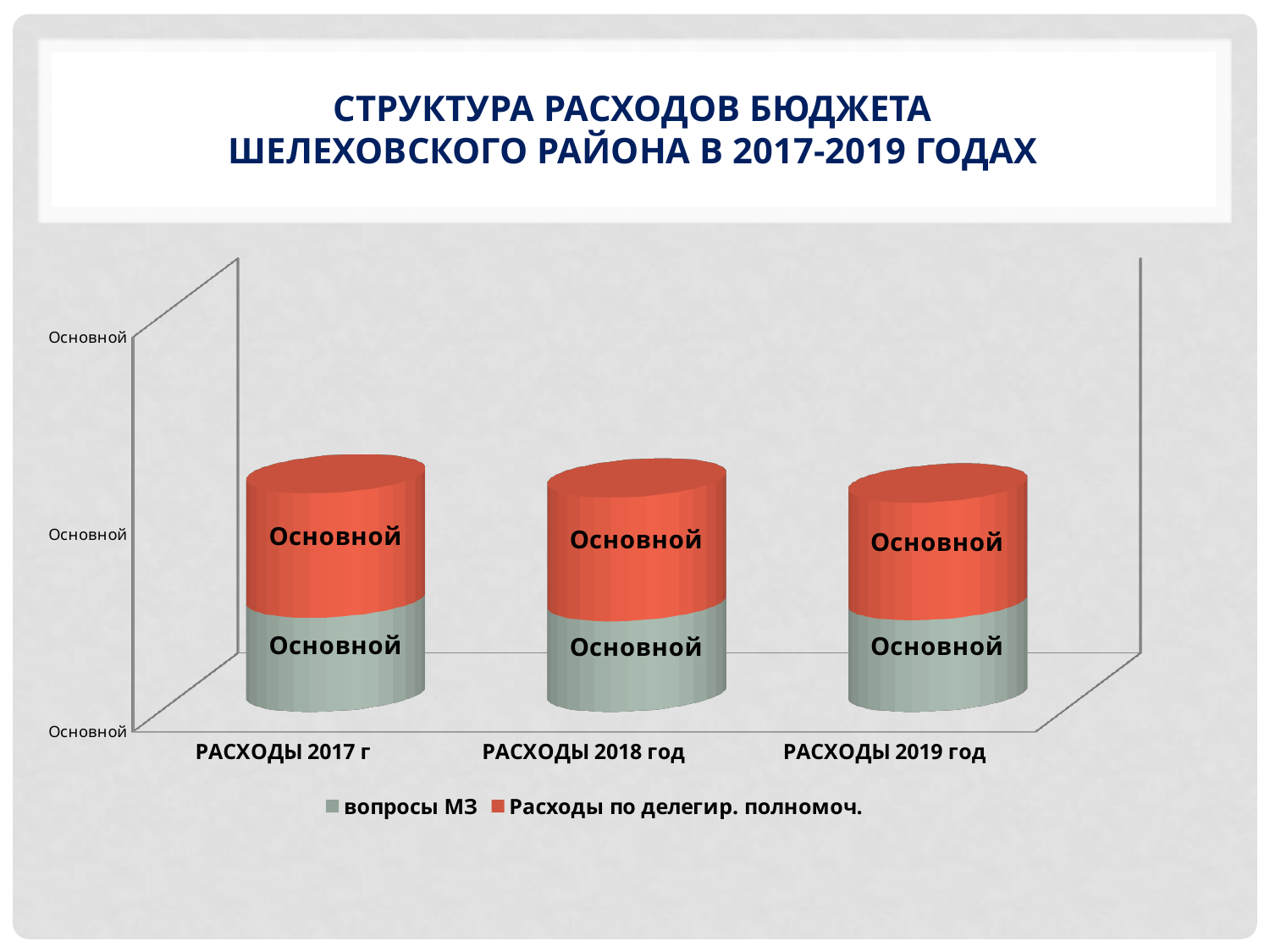
In the bar for РАСХОДЫ 2018 год, is the вопросы МЗ segment larger or smaller than the Расходы по делегир. полномоч. segment? smaller What is the title of the slide containing the chart? СТРУКТУРА РАСХОДОВ БЮДЖЕТА ШЕЛЕХОВСКОГО РАЙОНА В 2017-2019 ГОДАХ In the bar for РАСХОДЫ 2019 год, which segment is larger: вопросы МЗ or Расходы по делегир. полномоч.? Расходы по делегир. полномоч. What are the two series named in the legend? вопросы МЗ; Расходы по делегир. полномоч. In the bar for РАСХОДЫ 2017 г, which segment is larger: вопросы МЗ or Расходы по делегир. полномоч.? Расходы по делегир. полномоч. How many series does the legend list? 2 How many categories (years) are plotted along the x axis? 3 What kind of chart is shown on the slide? bar chart